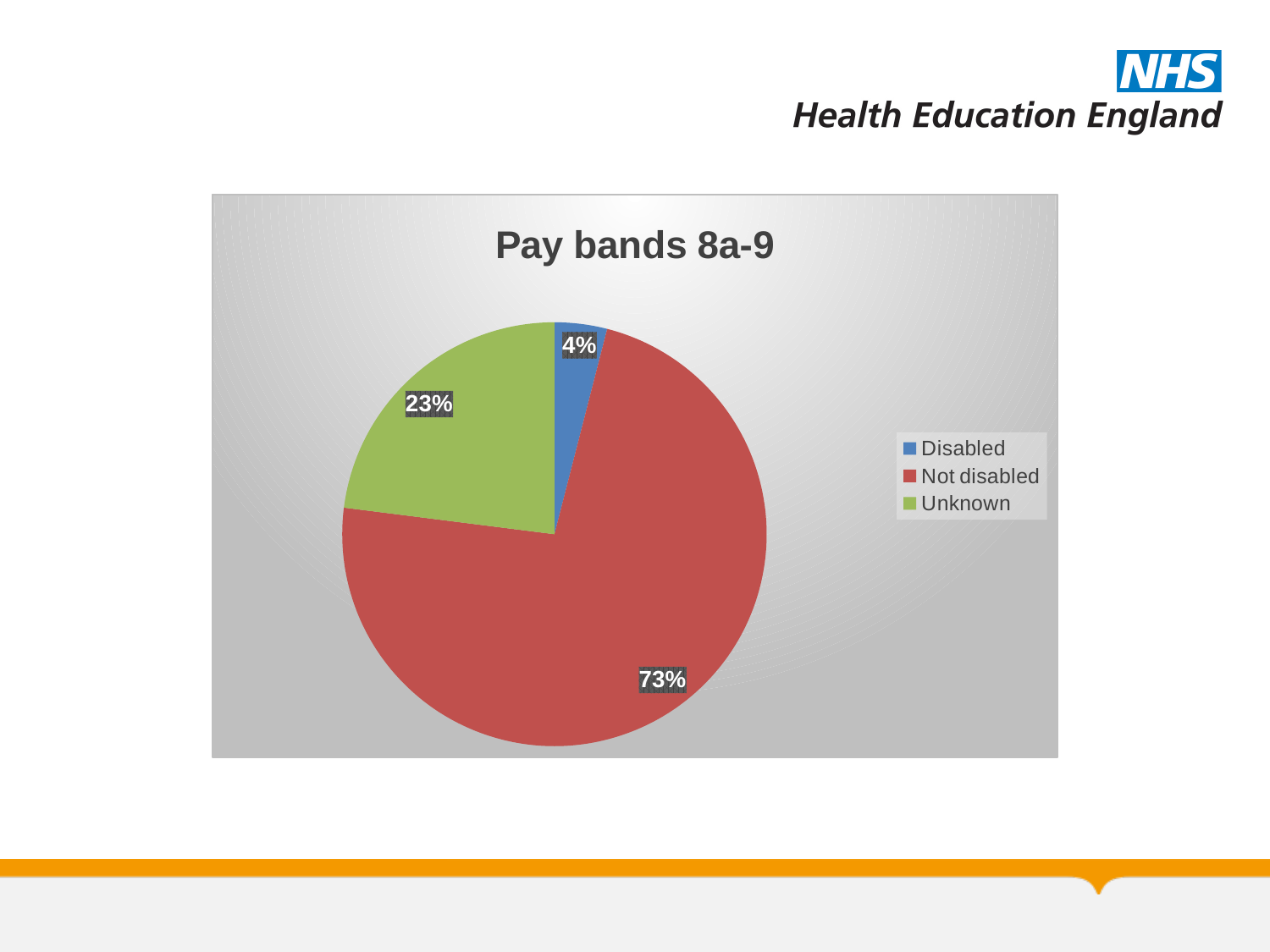
What is the difference in percentage points between the Not disabled and Unknown slices? 50 What percentage of the pie is labelled Not disabled? 73% What percentage of the pie is labelled Unknown? 23% What colour is the Unknown slice? green Which category has the smallest share of the pie? Disabled How many slices does the pie have? 3 How many categories does the legend list? 3 Which is larger, the Unknown slice or the Disabled slice? Unknown What kind of chart is shown on the slide? pie chart What is the title of the chart? Pay bands 8a-9 What percentage of the pie is labelled Disabled? 4% Which category has the largest share of the pie? Not disabled